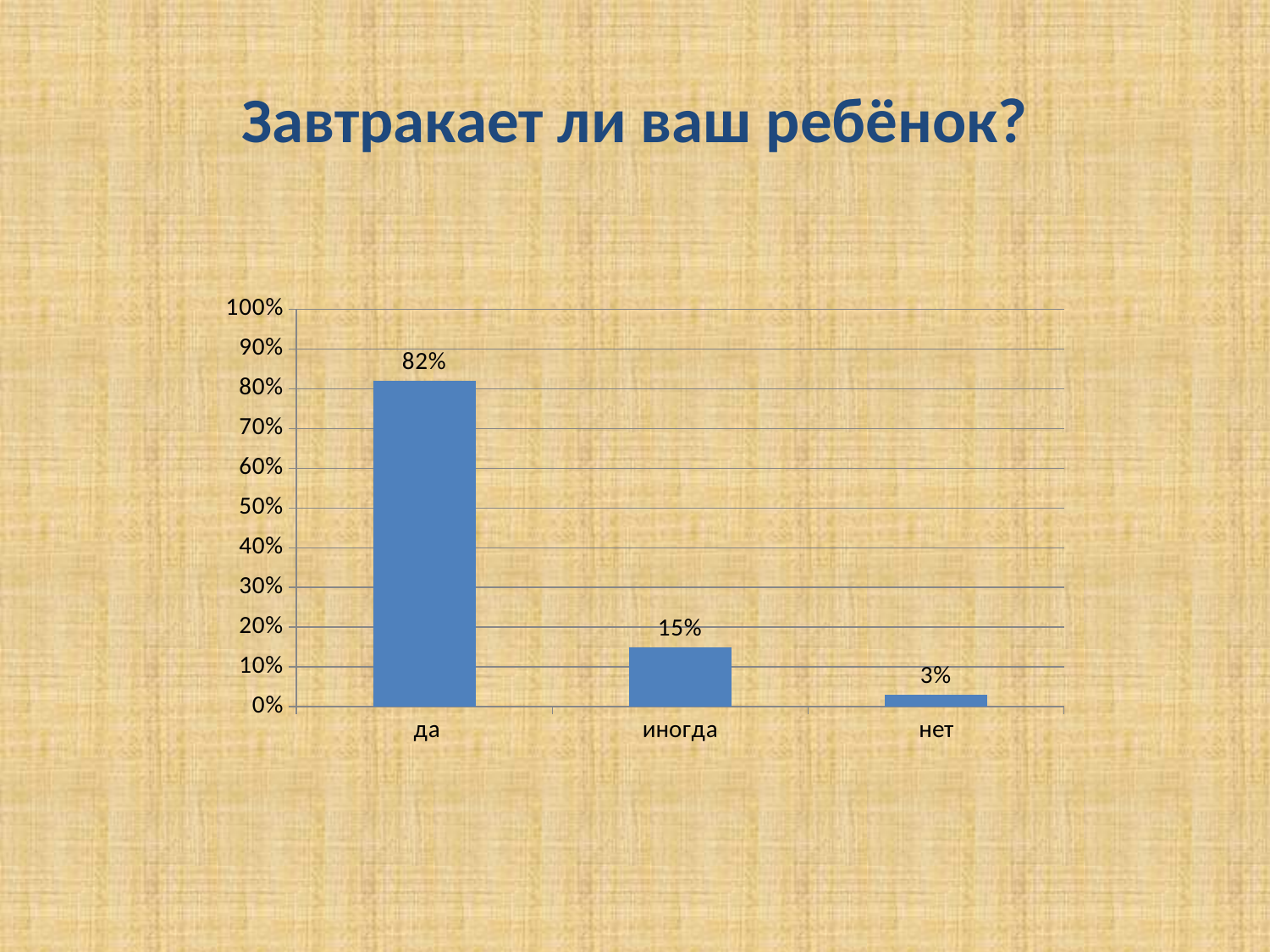
What is the difference between the values for "иногда" and "нет"? 12% What is the title of the slide? Завтракает ли ваш ребёнок? Which category has the lowest value? нет What is the value for "да"? 82% What kind of chart is shown on the slide? bar chart What is the difference between the values for "да" and "иногда"? 67% Which is larger, the value for "иногда" or the value for "нет"? иногда Is the value for "да" greater or less than 50%? greater What is the value for "нет"? 3% Which category has the highest value? да What is the value for "иногда"? 15% How many categories are shown on the x axis? 3